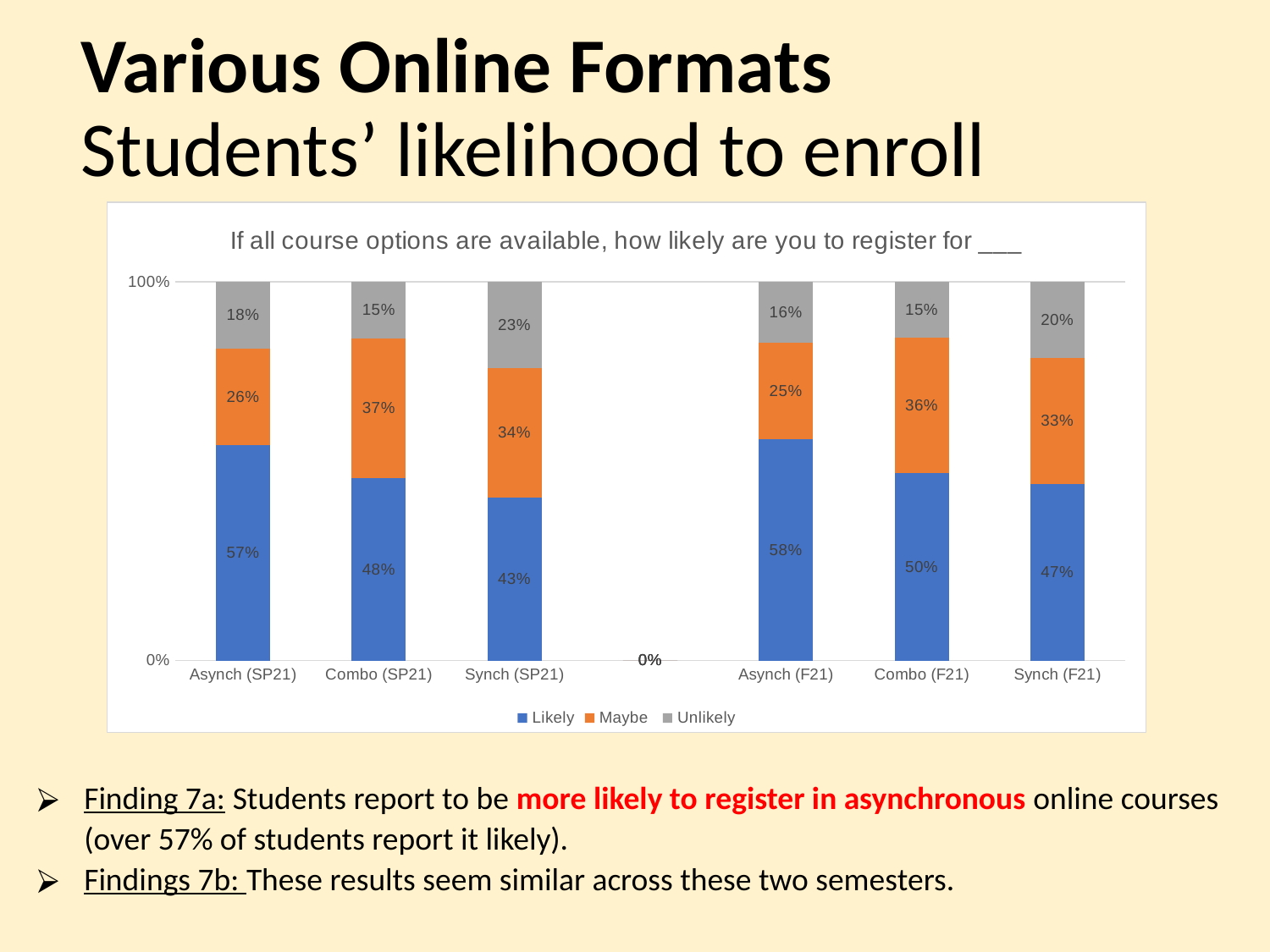
Which category has the highest Likely value? Asynch (F21) Which is larger, the Maybe value for Combo (SP21) or the Maybe value for Synch (F21)? Combo (SP21) What kind of chart is shown on the slide? Stacked bar chart How many labelled categories are shown on the x axis? 6 Which category has the lowest Likely value? Synch (SP21) What is the title of the chart? If all course options are available, how likely are you to register for ___ What percentage of students said they were likely to register for Asynch (SP21)? 57% What is the total of the stacked bar for Combo (F21)? 101% How many series does the legend list? 3 What is the Unlikely value for Synch (SP21)? 23% What is the difference between the Likely values for Asynch (SP21) and Synch (SP21)? 14% What is the Maybe value for Combo (F21)? 36%